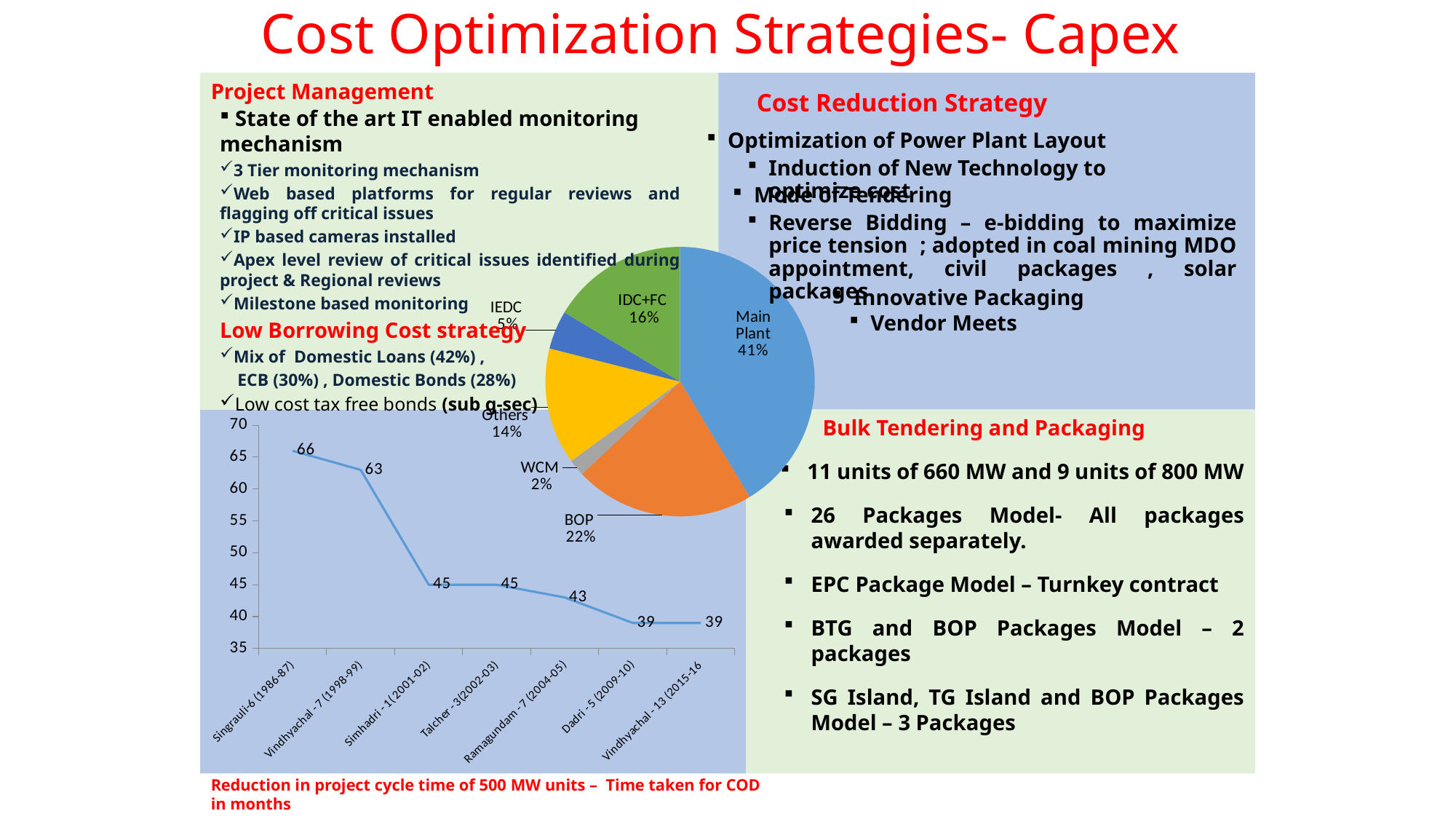
In the line chart at the bottom left, what is the difference between Singrauli-6 (1986-87) and Vindhyachal - 13 (2015-16)? 27 In the pie chart, which slice is the largest? Main Plant In the pie chart, what share does BOP have? 22% In the line chart at the bottom left, do the values generally rise or fall from left to right? fall In the pie chart, what share does Main Plant have? 41% In the line chart at the bottom left, which project has the highest value? Singrauli-6 (1986-87) In the pie chart, what is the difference between the IDC+FC share and the IEDC share? 11% In the pie chart, how many slices are there? 6 In the line chart at the bottom left, what is the value for Simhadri - 1 (2001-02)? 45 In the line chart at the bottom left, how many projects are plotted on the x axis? 7 In the pie chart, which slice is the smallest? WCM In the line chart at the bottom left, what is the value for Singrauli-6 (1986-87)? 66